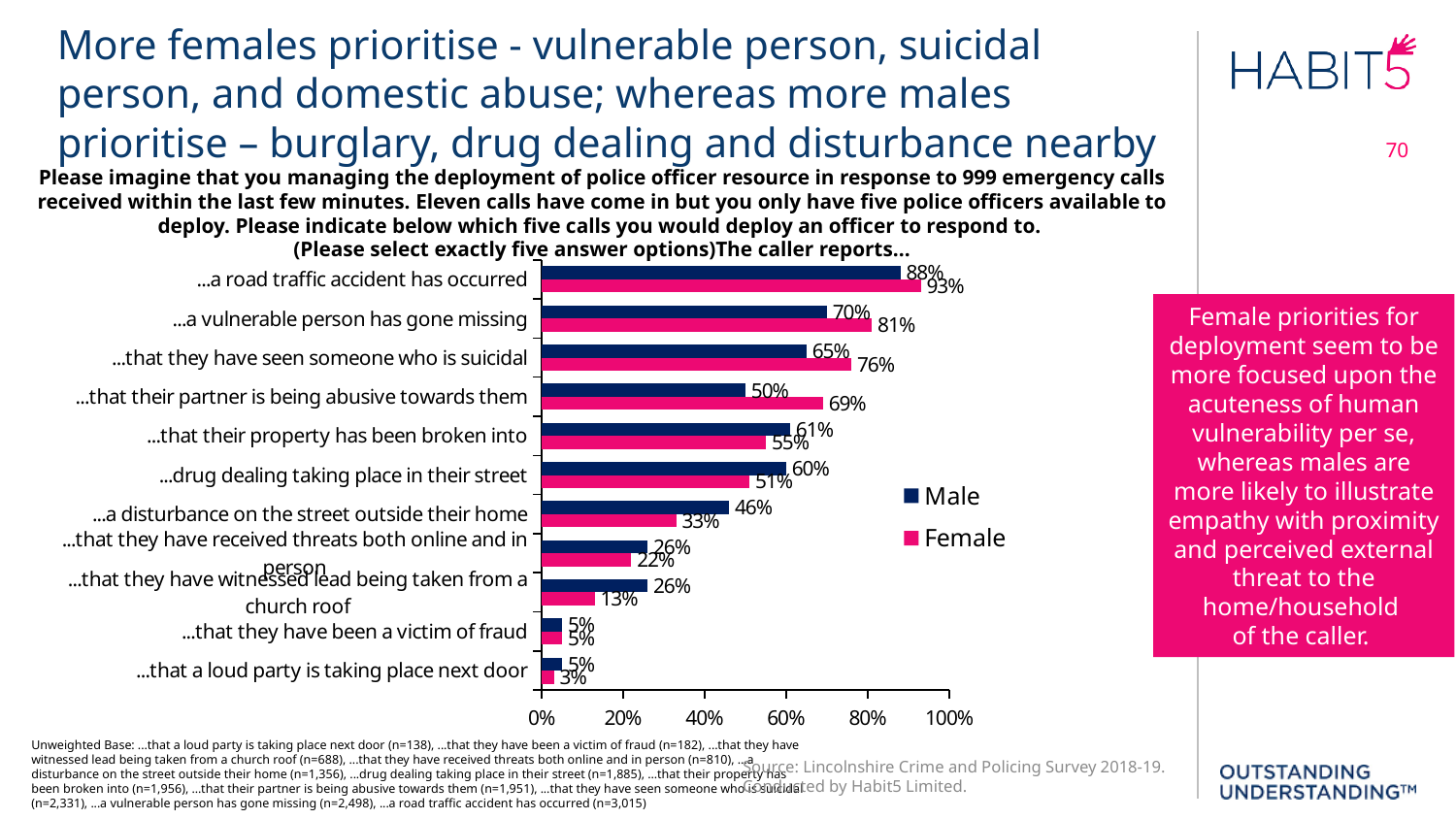
What is the difference between the male and female percentages for 'a disturbance on the street outside their home'? 13 percentage points What is the difference between the female and male percentages for 'that their partner is being abusive towards them'? 19 percentage points How many call types are shown on the chart? 11 For 'that they have witnessed lead being taken from a church roof', which is larger, the male or female value? Male Which call has the lowest percentage for females? ...that a loud party is taking place next door What is the female value for 'that their partner is being abusive towards them'? 69% What percentage of females would deploy an officer to a road traffic accident? 93% Which call has the highest percentage for males? ...a road traffic accident has occurred What percentage of males would deploy an officer when a vulnerable person has gone missing? 70% What type of chart is shown on the slide? Bar chart For 'that their property has been broken into', is the male or female percentage higher? Male How many series does the legend list? 2